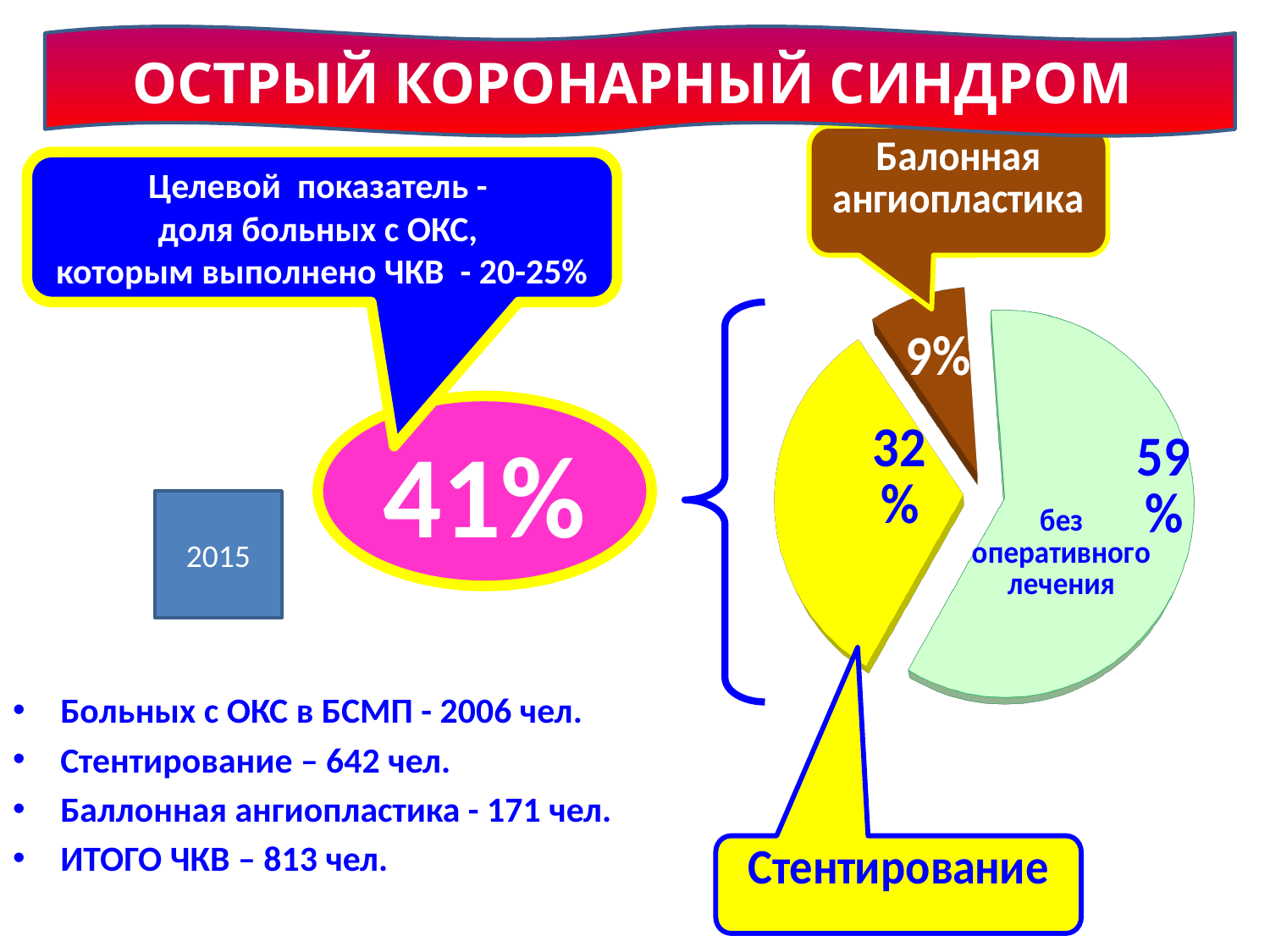
Which slice of the pie chart is the largest? без оперативного лечения What is the difference between the "без оперативного лечения" share and the "Стентирование" share? 27% How many slices does the pie chart have? 3 What is the combined share of the "Стентирование" and "Балонная ангиопластика" slices? 41% What share of the pie is labelled "без оперативного лечения"? 59% What year is shown in the box to the left of the pie chart? 2015 What colour is the "Стентирование" slice of the pie chart? yellow Which is larger in the pie chart: the share for "Стентирование" or the share for "Балонная ангиопластика"? Стентирование What share of the pie corresponds to "Стентирование"? 32% Which slice of the pie chart is the smallest? Балонная ангиопластика What share of the pie corresponds to "Балонная ангиопластика"? 9% What kind of chart is shown on the slide? pie chart